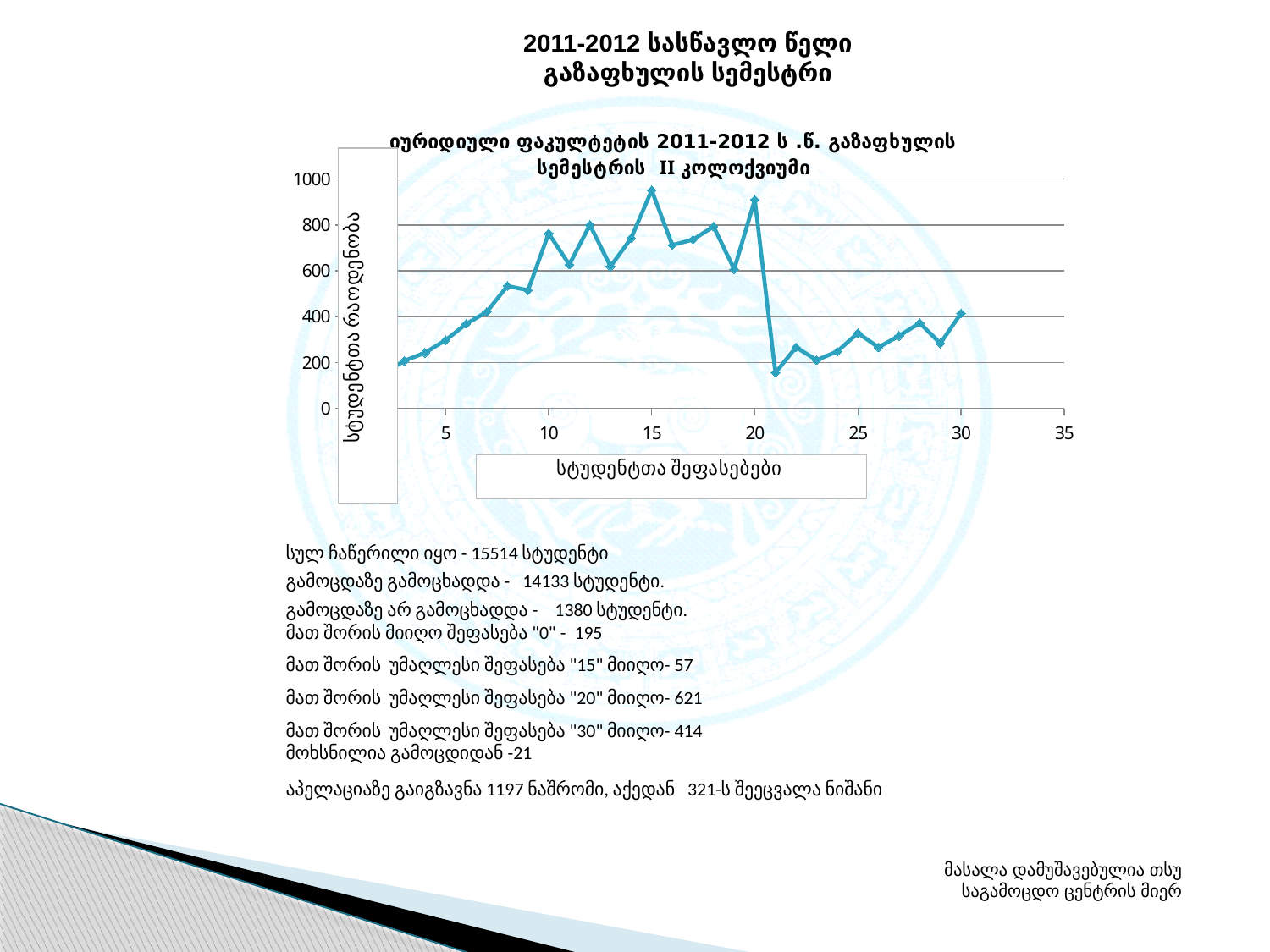
What is the label of the x axis? სტუდენტთა შეფასებები What is the label of the y axis? სტუდენტთა რაოდენობა Is the value at grade 15 greater or less than 800? greater Is the value at grade 25 greater or less than 400? less Is the value at grade 20 greater or less than 800? greater Does the line rise or fall between grade 20 and grade 21? fall What kind of chart is shown on the slide? line chart